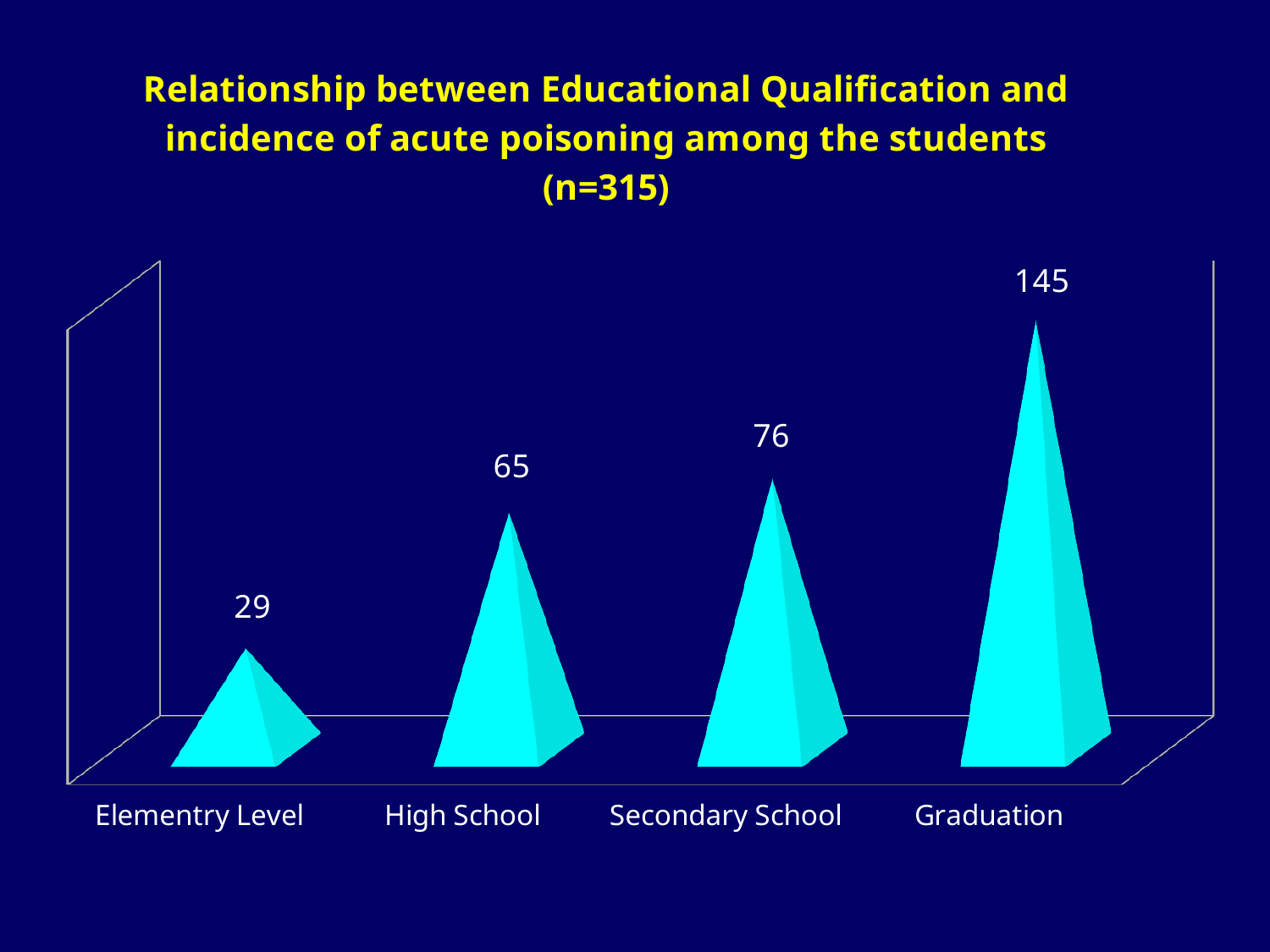
Which is larger, the value for Secondary School or the value for High School? Secondary School What is the difference between the values for Graduation and Secondary School? 69 What is the value for Elementry Level? 29 Which category has the highest value? Graduation What is the value for Graduation? 145 What is the value for Secondary School? 76 Do the values rise or fall from Elementry Level to Graduation along the x axis? rise What is the value for High School? 65 What is the difference between the values for High School and Elementry Level? 36 How many categories are shown on the x axis? 4 Which category has the lowest value? Elementry Level What is the sample size (n) stated in the chart title? 315